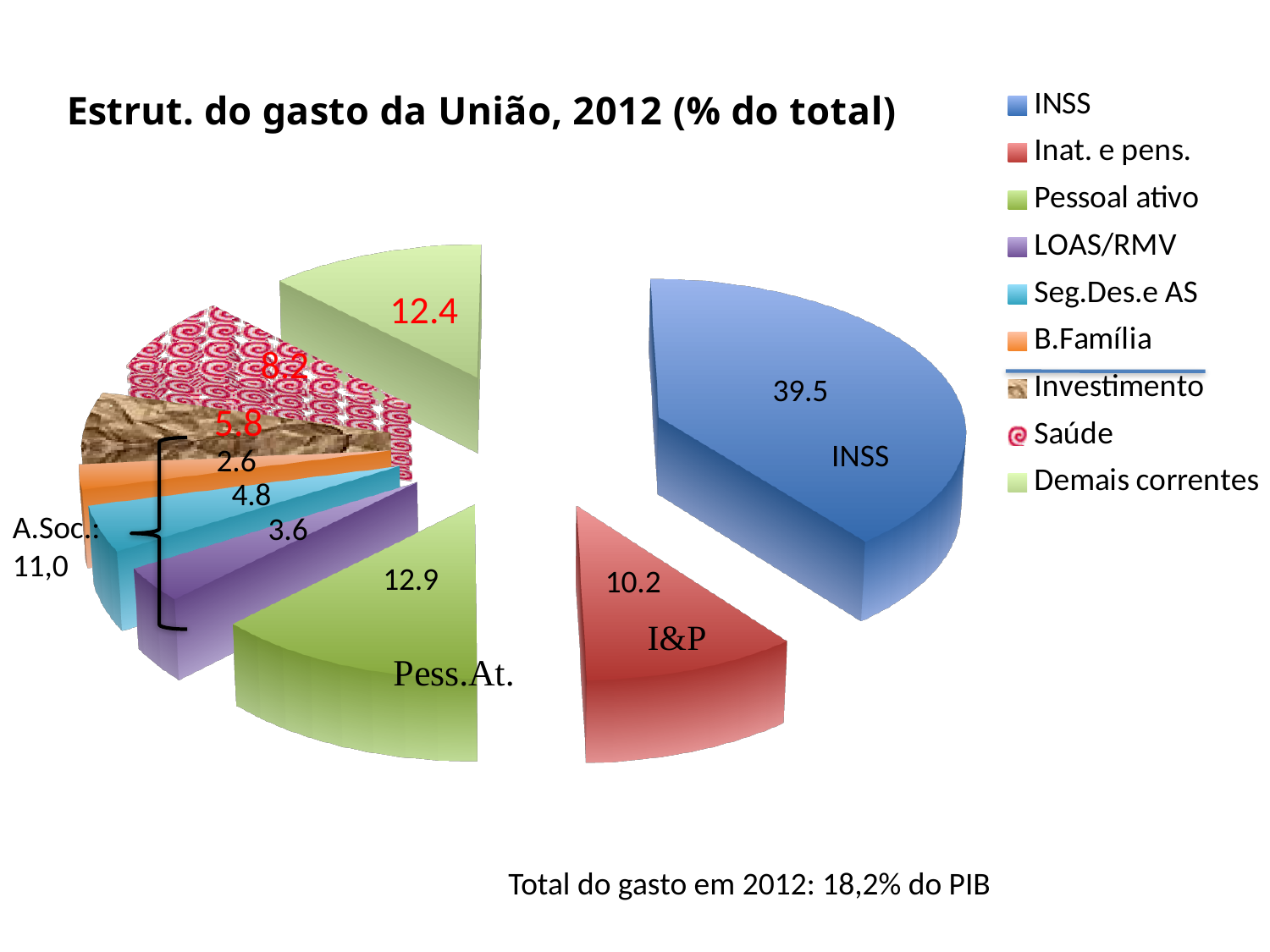
What is the value for INSS? 39.5 What is the value for Pessoal ativo? 12.9 What is the value for Saúde? 8.2 How many entries does the legend list? 9 Which category has the largest slice of the pie? INSS What type of chart is shown on the slide? pie chart What is the value for B.Família? 2.6 Which is larger, the value for Demais correntes or the value for Inat. e pens.? Demais correntes Which category has the smallest slice of the pie? B.Família What is the value for Inat. e pens. (I&P)? 10.2 What is the difference between the values for INSS and Pessoal ativo? 26.6 What is the title of the chart? Estrut. do gasto da União, 2012 (% do total)